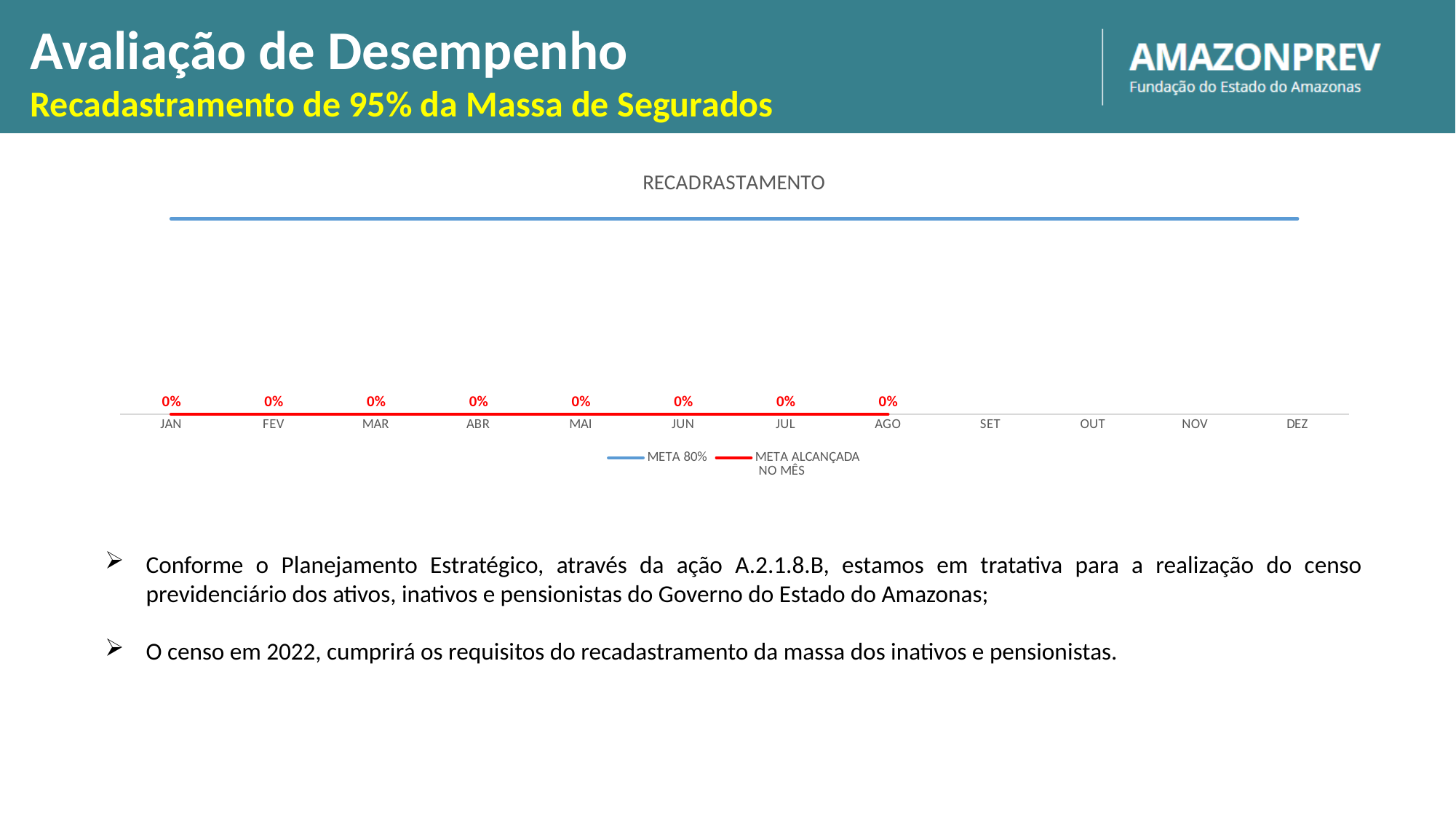
How many series does the chart legend list? 2 What is the value of META ALCANÇADA NO MÊS for MAI? 0% What kind of chart is shown on the slide? line chart How many months have a data label for META ALCANÇADA NO MÊS? 8 In JAN, which series is higher, META 80% or META ALCANÇADA NO MÊS? META 80% How many months are shown on the x axis of the chart? 12 What is the value of META ALCANÇADA NO MÊS for JAN? 0% Does the META ALCANÇADA NO MÊS series rise, fall or stay flat from JAN to AGO? stays flat What is the value of META ALCANÇADA NO MÊS for AGO? 0% What is the title of the chart? RECADRASTAMENTO Which is the last month with a plotted value for META ALCANÇADA NO MÊS? AGO What are the two series named in the chart legend? META 80% and META ALCANÇADA NO MÊS